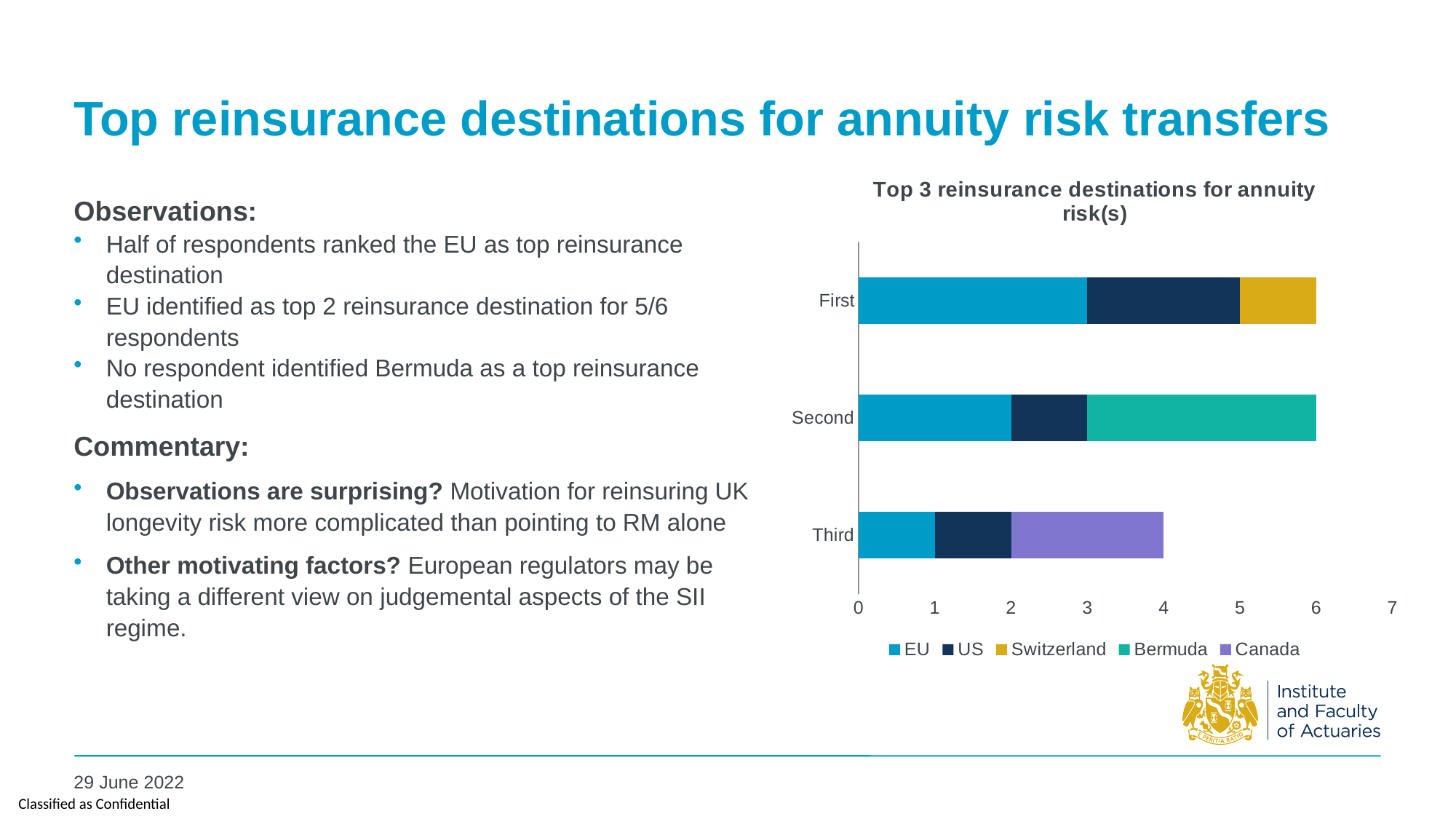
What is the total length of the stacked bar for Third? 4 Which series appears only in the Third bar? Canada What is the total length of the stacked bar for First? 6 Is the EU value for Second greater or less than 1? greater What is the title of the chart? Top 3 reinsurance destinations for annuity risk(s) What is the value for EU in the First bar? 3 Which is larger, the EU value for First or the EU value for Second? First What is the value for EU in the Third bar? 1 How many categories are shown on the vertical axis? 3 What kind of chart is shown on the slide? stacked bar chart How many series does the legend list? 5 Which category has the shortest stacked bar in total? Third